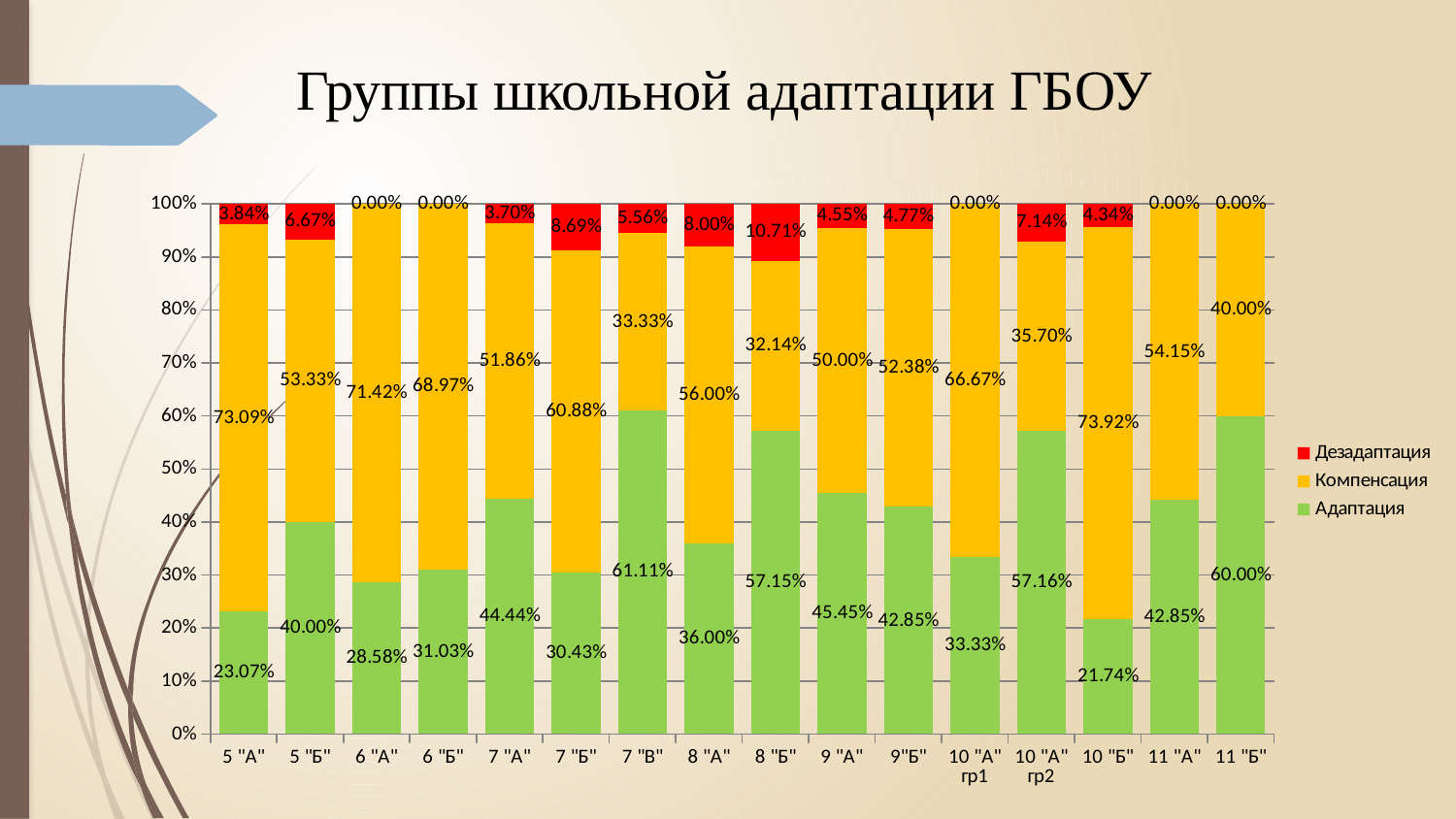
Which class has the lowest Адаптация value? 10 "Б" How many series does the legend list? 3 What is the title of the chart? Группы школьной адаптации ГБОУ What type of chart is shown on the slide? stacked bar chart What is the difference between the Адаптация values for 11 "Б" and 5 "Б"? 20.00% How many classes (categories) are shown on the x axis? 16 What is the Адаптация value for 7 "В"? 61.11% Which class has the highest Дезадаптация value? 8 "Б" Which series is shown in red in the legend? Дезадаптация Which is larger, the Компенсация value for 6 "А" or for 6 "Б"? 6 "А" What is the Дезадаптация value for 8 "Б"? 10.71% What is the Компенсация value for 10 "Б"? 73.92%